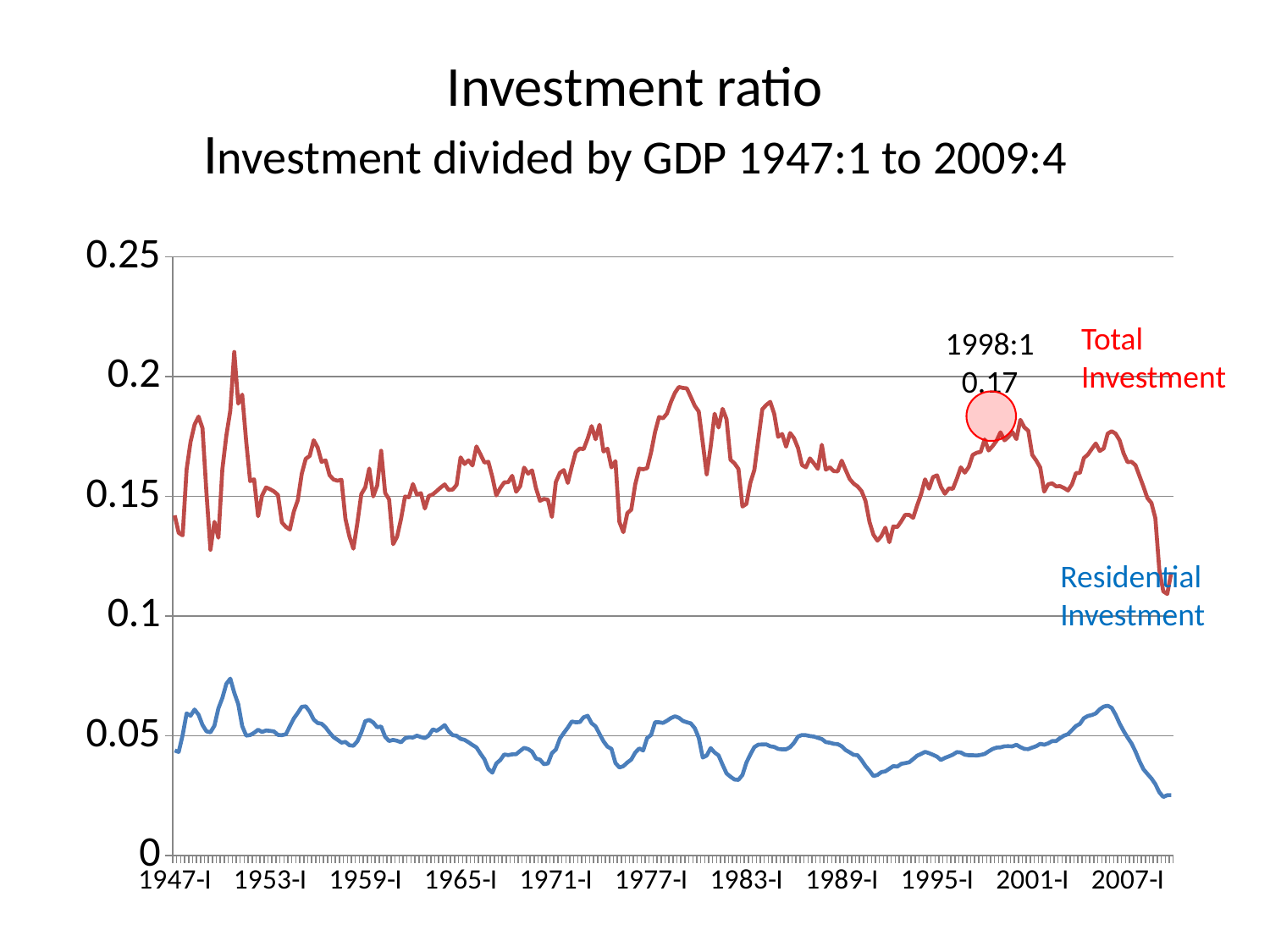
Is the highest value reached by Residential Investment greater or less than 0.1? less How many year labels are shown on the x axis? 11 Is the final value of Residential Investment (at the right end of the chart) greater or less than 0.05? less How many data series are plotted on the chart? 2 What colour is the Total Investment line? red What is the value of Total Investment at 1998:1, as annotated on the chart? 0.17 Does Residential Investment rise or fall between 2007-I and the end of the chart? fall What kind of chart is shown on the slide? line chart What is the title of the chart? Investment ratio Is the highest value reached by Total Investment greater or less than 0.2? greater Which series has higher values throughout the chart, Total Investment or Residential Investment? Total Investment